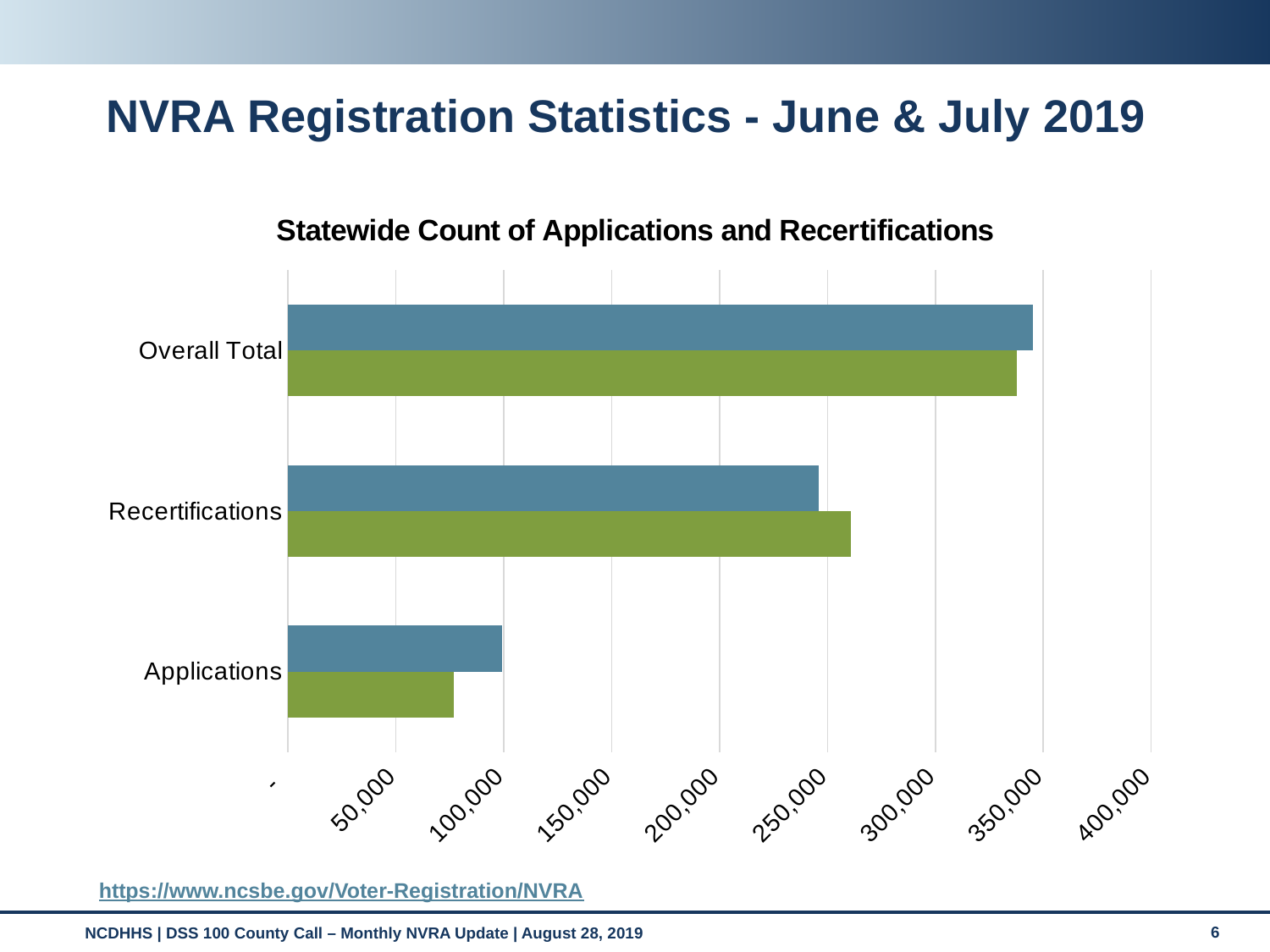
Which category has the longest bars? Overall Total For Applications, is the blue bar or the green bar longer? Blue Which category has the shortest bars? Applications Is the value of the green bar for Applications greater or less than 100,000? less Is the value of the green bar for Recertifications greater or less than 250,000? greater For Recertifications, is the blue bar or the green bar longer? Green What is the title of the chart? Statewide Count of Applications and Recertifications What kind of chart is shown on the slide? Bar chart Is the value of the blue bar for Overall Total greater or less than 300,000? greater What is the highest value shown on the horizontal axis? 400,000 How many categories are shown on the chart's vertical axis? 3